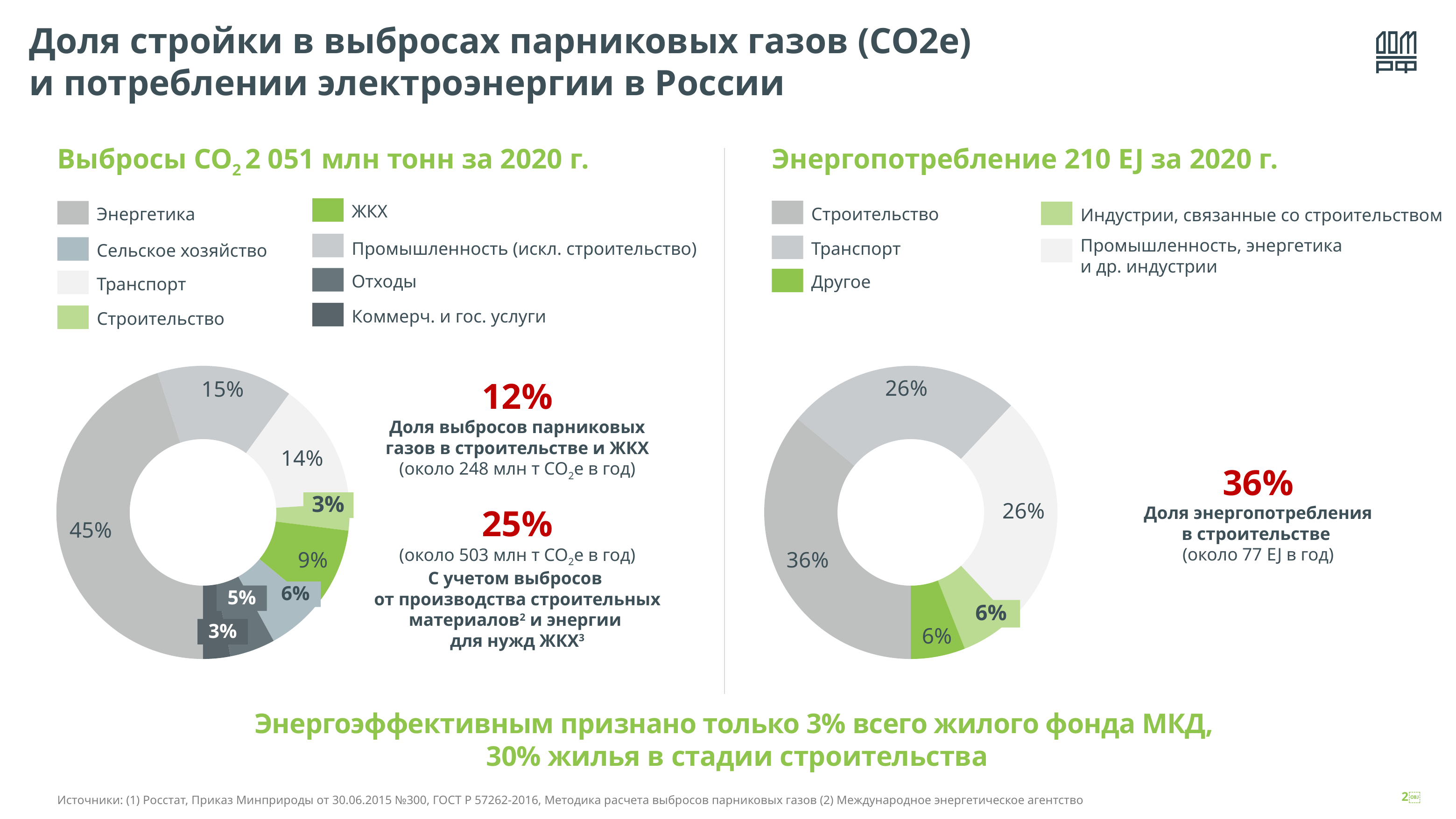
On the right chart (Энергопотребление), what share does Другое have? 6% On the left chart (Выбросы CO2), how many categories does the legend list? 8 On the right chart (Энергопотребление), how many categories does the legend list? 5 On the left chart (Выбросы CO2), what share does Транспорт have? 14% What type of chart is used on the right side (Энергопотребление)? Pie (donut) chart On the left chart (Выбросы CO2), what share does ЖКХ have? 9% On the left chart (Выбросы CO2), which category has the largest share? Энергетика On the left chart (Выбросы CO2), what share does Энергетика have? 45% On the right chart (Энергопотребление), which is larger: Строительство or Транспорт? Строительство On the right chart (Энергопотребление), what share does Строительство have? 36% On the left chart (Выбросы CO2), what is the difference between the shares of Энергетика and Промышленность (искл. строительство)? 30% On the left chart (Выбросы CO2), what share does Строительство have? 3%